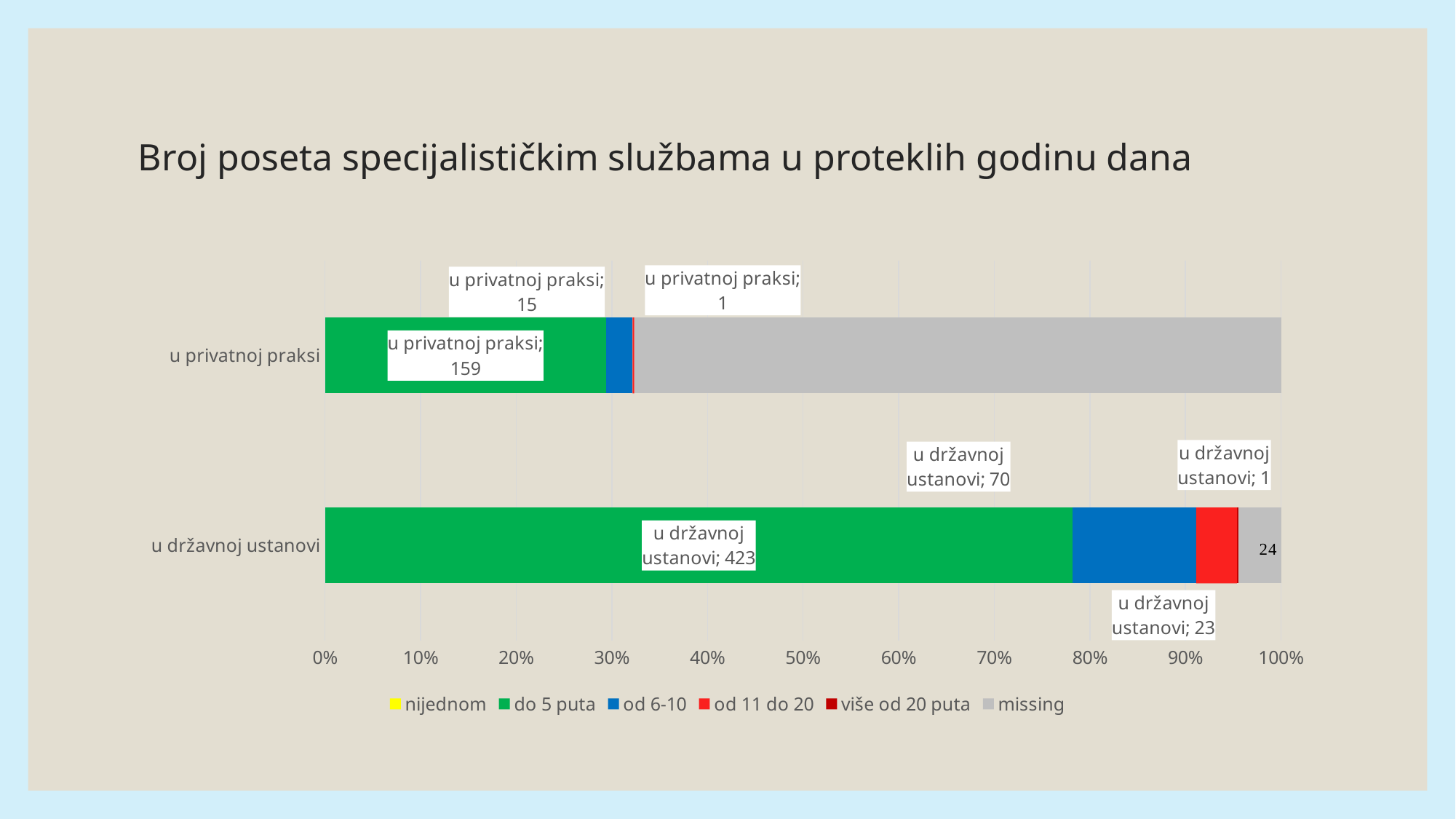
Which category has the larger 'od 6-10' value, 'u privatnoj praksi' or 'u državnoj ustanovi'? u državnoj ustanovi How many categories are plotted on the vertical axis? 2 Is the share of 'missing' in the 'u privatnoj praksi' bar greater or less than 60%? greater What is the title of the chart? Broj poseta specijalističkim službama u proteklih godinu dana How many series does the legend list? 6 What is the value of 'od 11 do 20' for 'u državnoj ustanovi'? 23 What kind of chart is shown on the slide? Stacked bar chart What is the difference between the 'do 5 puta' values for 'u državnoj ustanovi' and 'u privatnoj praksi'? 264 What is the value of 'do 5 puta' for 'u privatnoj praksi'? 159 What is the value of 'missing' for 'u državnoj ustanovi'? 24 Which series has the highest value in the 'u državnoj ustanovi' bar? do 5 puta What is the value of 'od 6-10' for 'u državnoj ustanovi'? 70